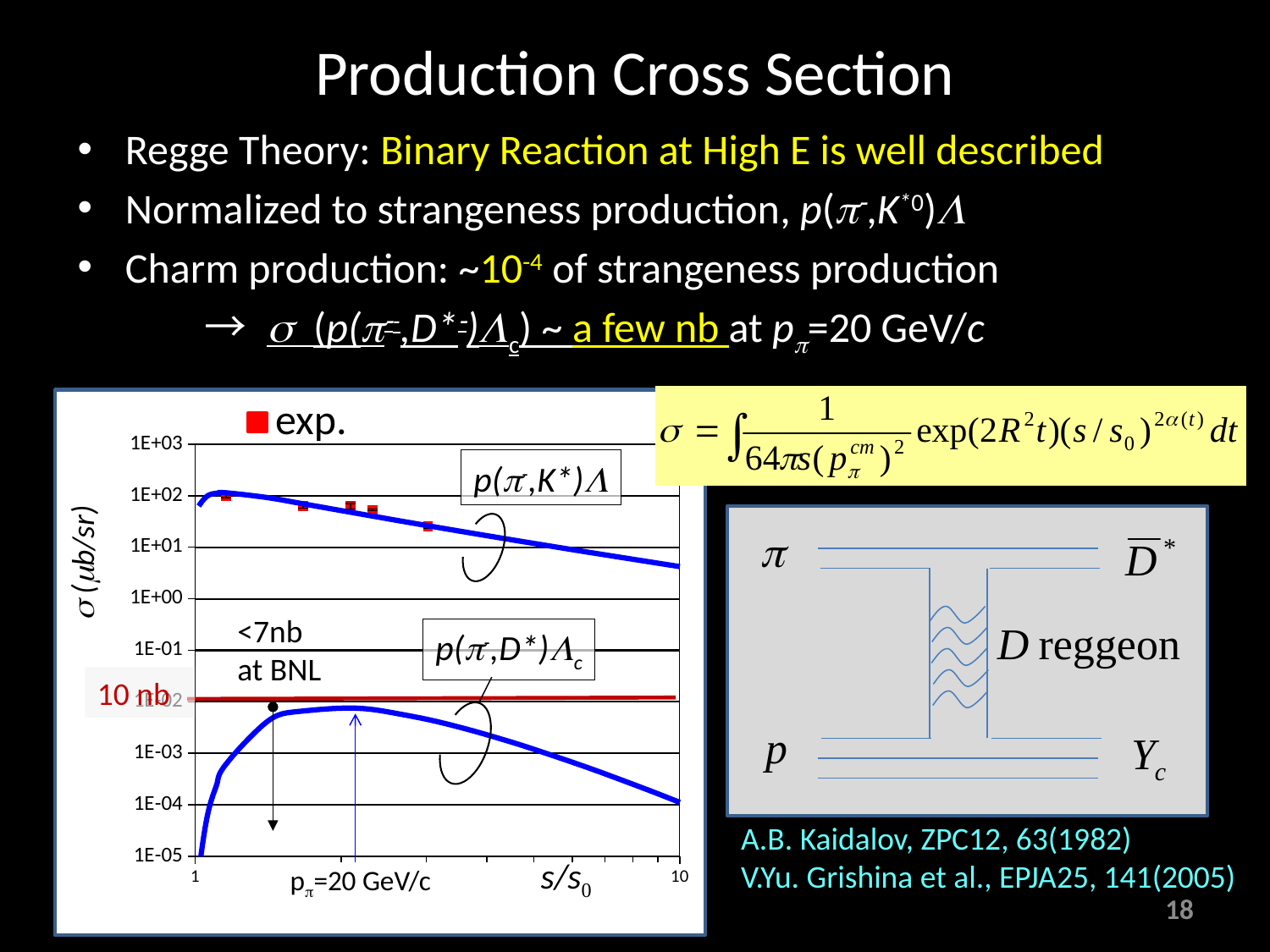
How many entries does the chart legend list? 1 What is the lowest tick value shown on the vertical axis of the chart? 1E-05 What is the label of the vertical axis of the chart? σ (μb/sr) Which curve lies higher on the chart, p(π,K*)Λ or p(π,D*)Λc? p(π,K*)Λ How many labelled curves are plotted on the chart? 2 Is the value of the p(π,D*)Λc curve at s/s0 = 10 greater or less than 1E-02? less What is the legend entry shown above the chart? exp. What kind of chart is shown on the slide? line chart Is the peak value of the p(π,D*)Λc curve greater or less than 1E-02? less Is the value of the p(π,K*)Λ curve at s/s0 = 10 greater or less than 1E+01? less Does the p(π,K*)Λ curve rise or fall as s/s0 increases from about 2 to 10? fall What is the highest tick value shown on the vertical axis of the chart? 1E+03